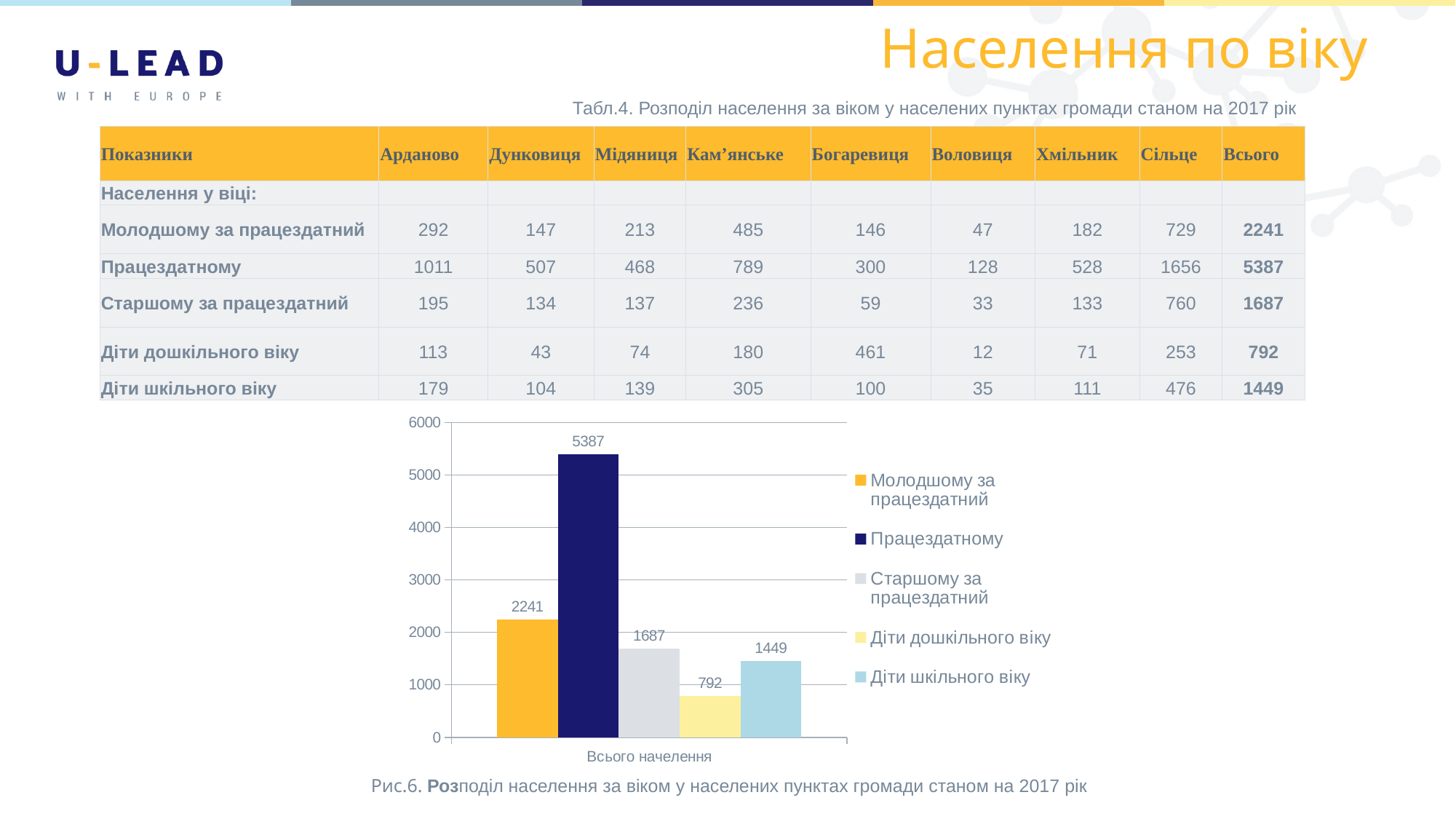
What is the value for Працездатному in the chart? 5387 Which is larger: the value for Старшому за працездатний or the value for Діти шкільного віку? Старшому за працездатний Which series has the lowest value in the chart? Діти дошкільного віку What kind of chart is shown on the slide? bar chart What is the difference between the values for Працездатному and Молодшому за працездатний? 3146 What is the difference between the values for Старшому за працездатний and Діти шкільного віку? 238 What is the value for Діти дошкільного віку in the chart? 792 How many series does the legend list? 5 What is the label on the x axis category of the chart? Всього начелення Which series has the highest value in the chart? Працездатному Is the value for Діти шкільного віку greater or less than 2000? less What is the value for Молодшому за працездатний in the chart? 2241